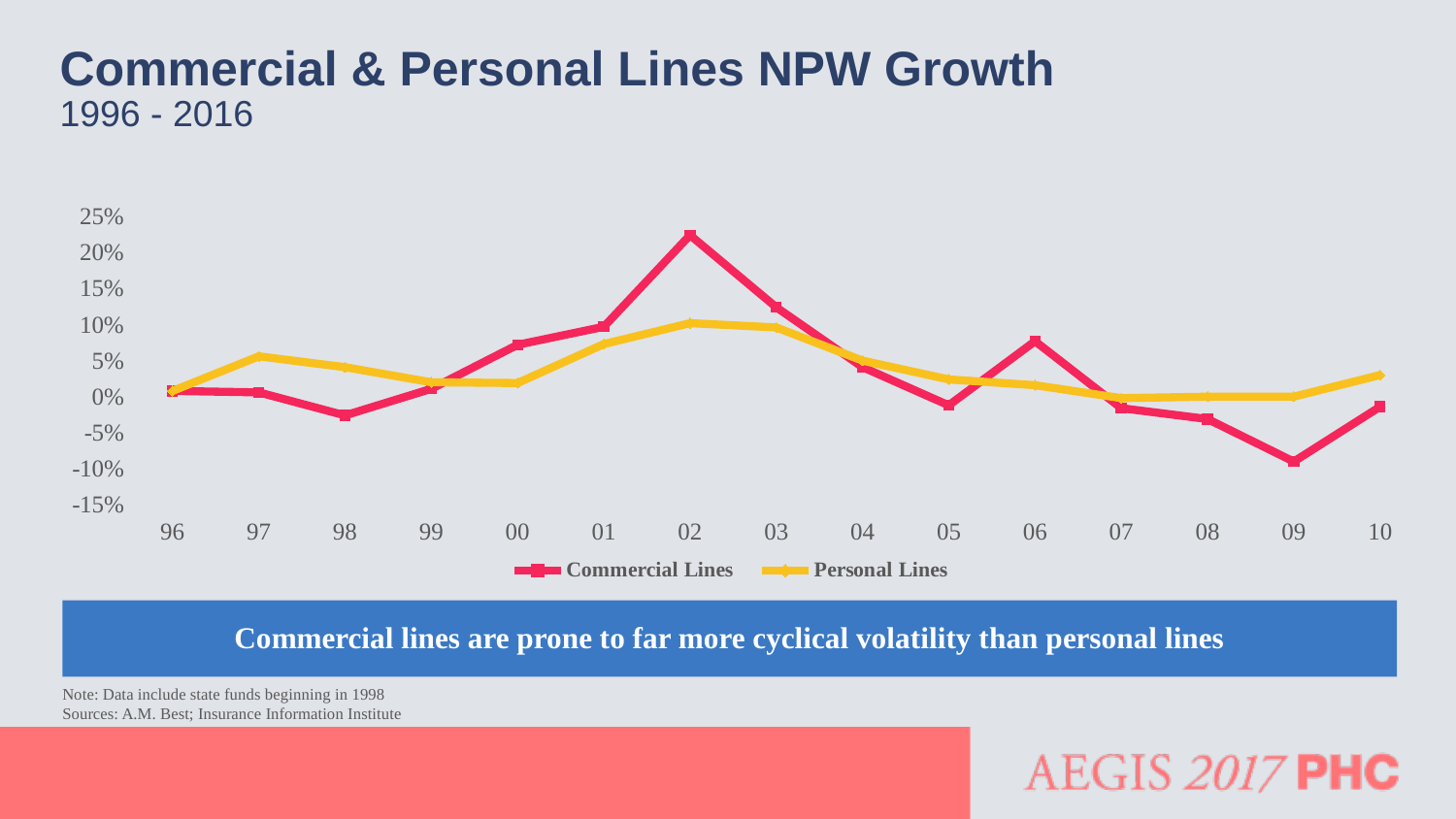
How many years are shown along the x axis? 15 Does the Commercial Lines series rise or fall from 06 to 09? Fall What kind of chart is shown on the slide? Line chart Is the Personal Lines value for 02 greater or less than 5%? greater In 02, which series has the larger value, Commercial Lines or Personal Lines? Commercial Lines In which year does the Commercial Lines series reach its highest value? 02 Is the Commercial Lines value for 09 greater or less than -5%? less Is the Commercial Lines value for 02 greater or less than 20%? greater In 09, which series has the larger value, Commercial Lines or Personal Lines? Personal Lines How many series does the legend list? 2 In which year does the Commercial Lines series reach its lowest value? 09 What is the title of the chart? Commercial & Personal Lines NPW Growth